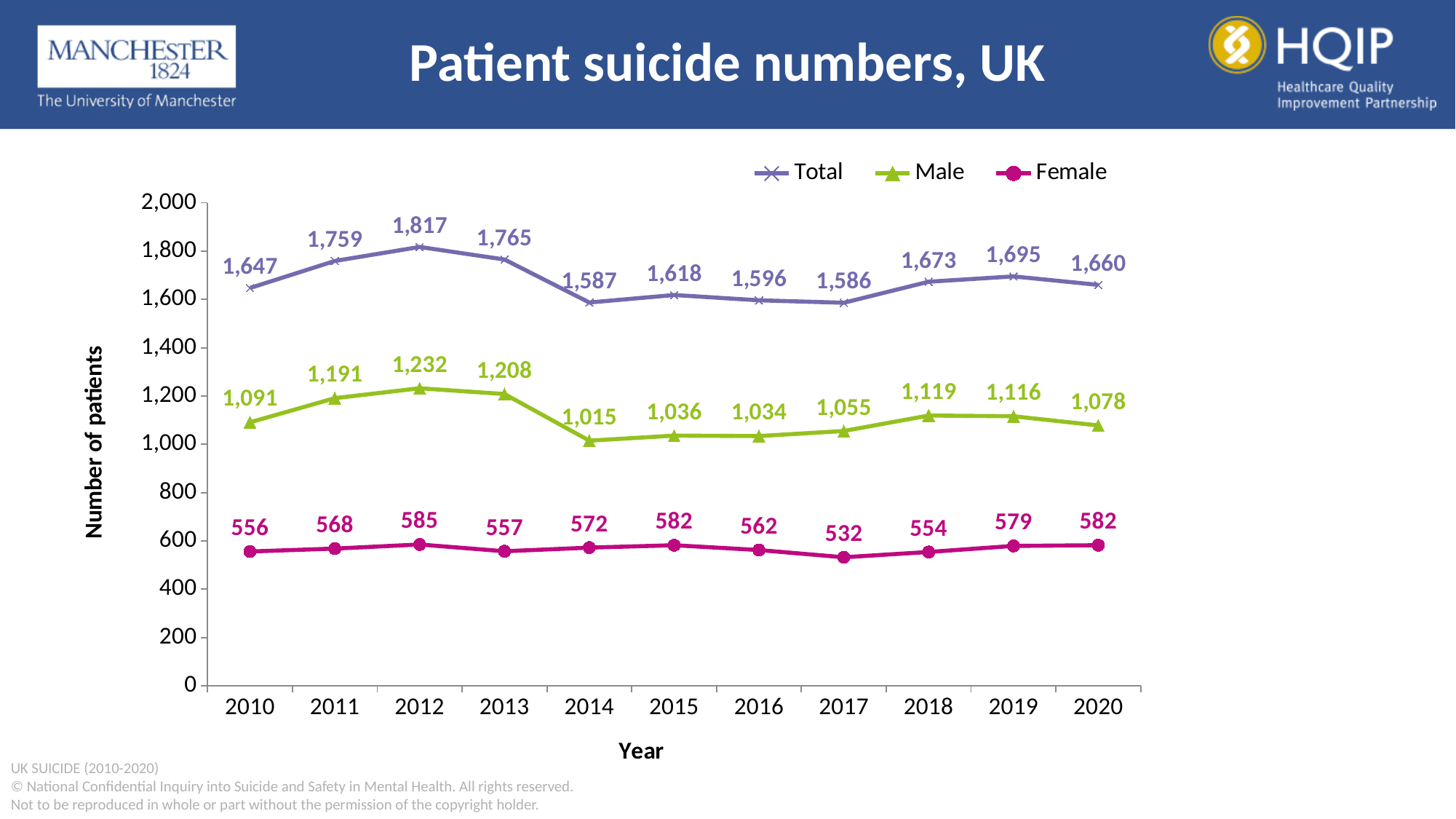
What is the Total value for 2012? 1,817 What is the difference between the Total values for 2012 and 2014? 230 In which year is the Total series highest? 2012 How many series does the legend list? 3 Is the Total value for 2017 greater or less than 1,600? less What kind of chart is shown on the slide? line chart Which is larger, the Male value for 2018 or the Male value for 2019? 2018 What is the Female value for 2017? 532 What is the Male value for 2014? 1,015 How many years are shown on the x axis? 11 What is the title of the chart? Patient suicide numbers, UK In which year is the Female series lowest? 2017